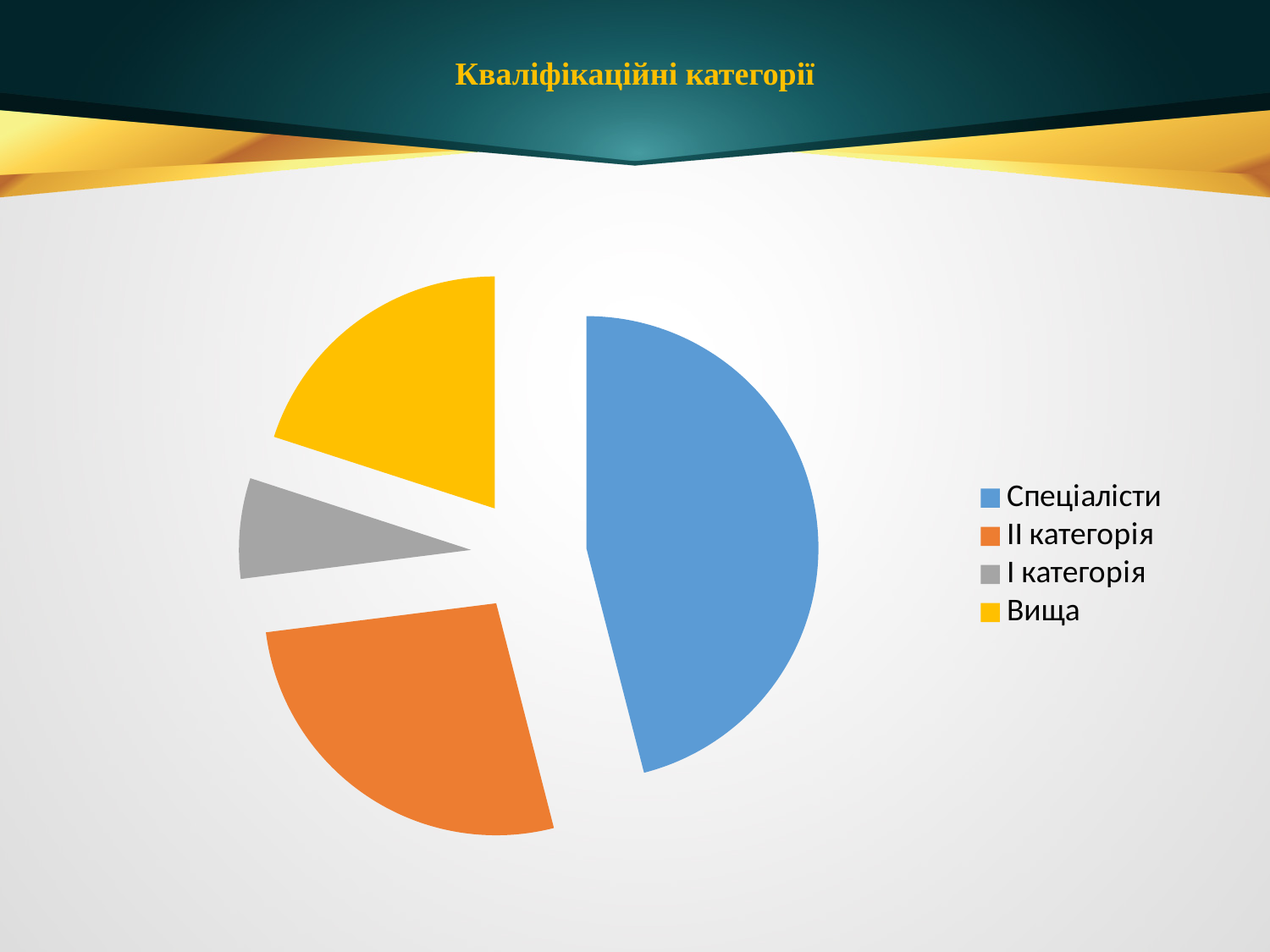
Which slice is larger, Спеціалісти or ІІ категорія? Спеціалісти How many categories does the pie chart show? 4 Which slice is larger, ІІ категорія or І категорія? ІІ категорія What is the title of the chart on the slide? Кваліфікаційні категорії Which slice is larger, І категорія or Вища? Вища How many entries does the legend list? 4 Which category has the smallest slice of the pie? І категорія What colour is the slice for Вища? yellow What kind of chart is shown on the slide? pie chart Which category has the largest slice of the pie? Спеціалісти